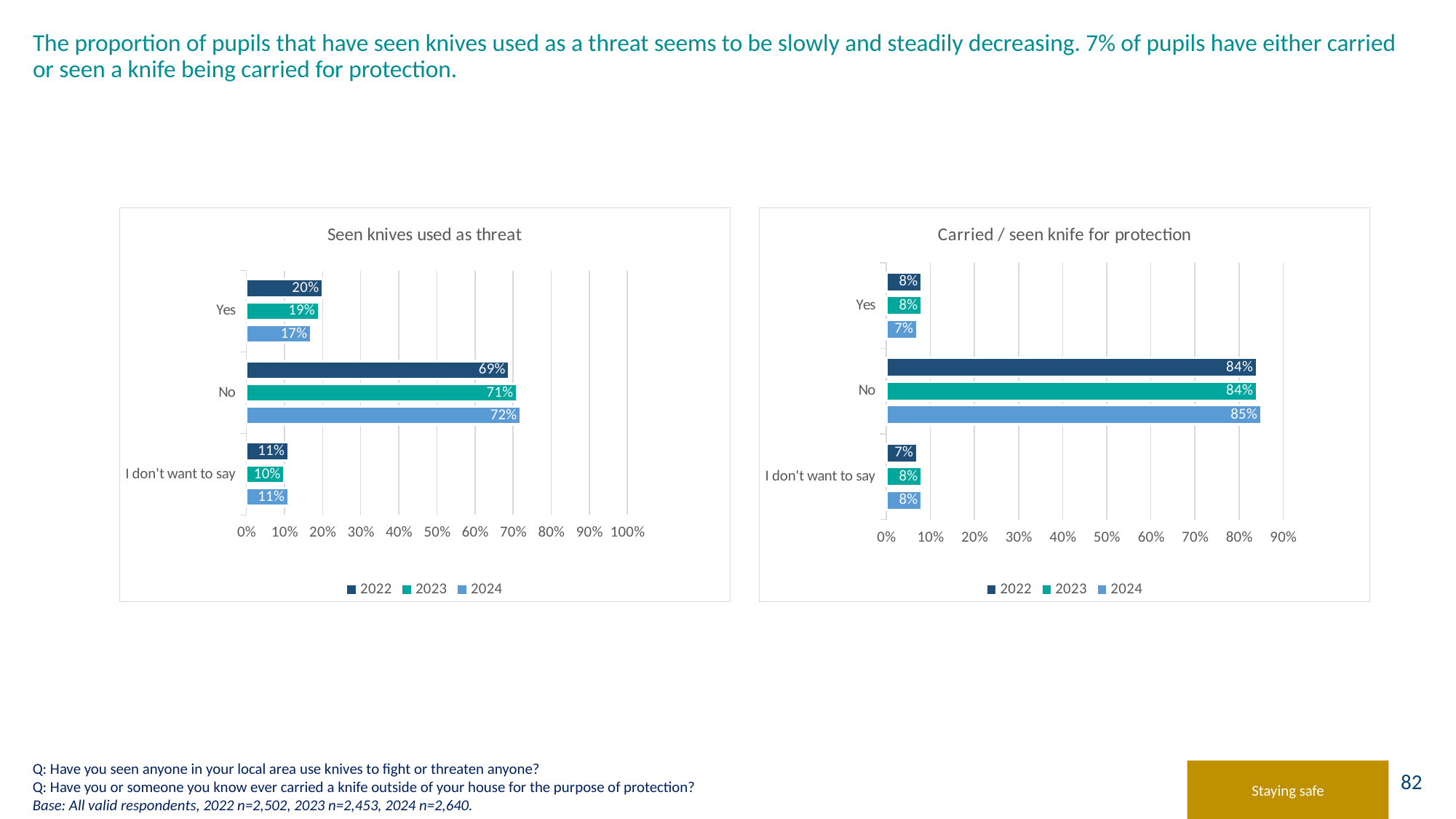
How many categories are shown in the 'Seen knives used as threat' chart? 3 How many series does the legend list in the 'Carried / seen knife for protection' chart? 3 In the 'Carried / seen knife for protection' chart, what is the difference between the 'No' value for 2024 and the 'Yes' value for 2024? 78% In the 'Seen knives used as threat' chart, what is the difference between the 'Yes' values for 2022 and 2024? 3% In the 'Seen knives used as threat' chart, which category has the highest value in 2023? No In the 'Seen knives used as threat' chart, which category has the lowest value in 2022? I don't want to say In the 'Seen knives used as threat' chart, is the 'No' value for 2024 larger or smaller than the 'No' value for 2022? larger In the 'Seen knives used as threat' chart, what is the value for 'No' in 2022? 69% In the 'Carried / seen knife for protection' chart, what is the value for 'Yes' in 2024? 7% In the 'Seen knives used as threat' chart, what is the value for 'Yes' in 2024? 17% What kind of chart is the 'Carried / seen knife for protection' chart? bar chart In the 'Carried / seen knife for protection' chart, what is the value for 'I don't want to say' in 2022? 7%